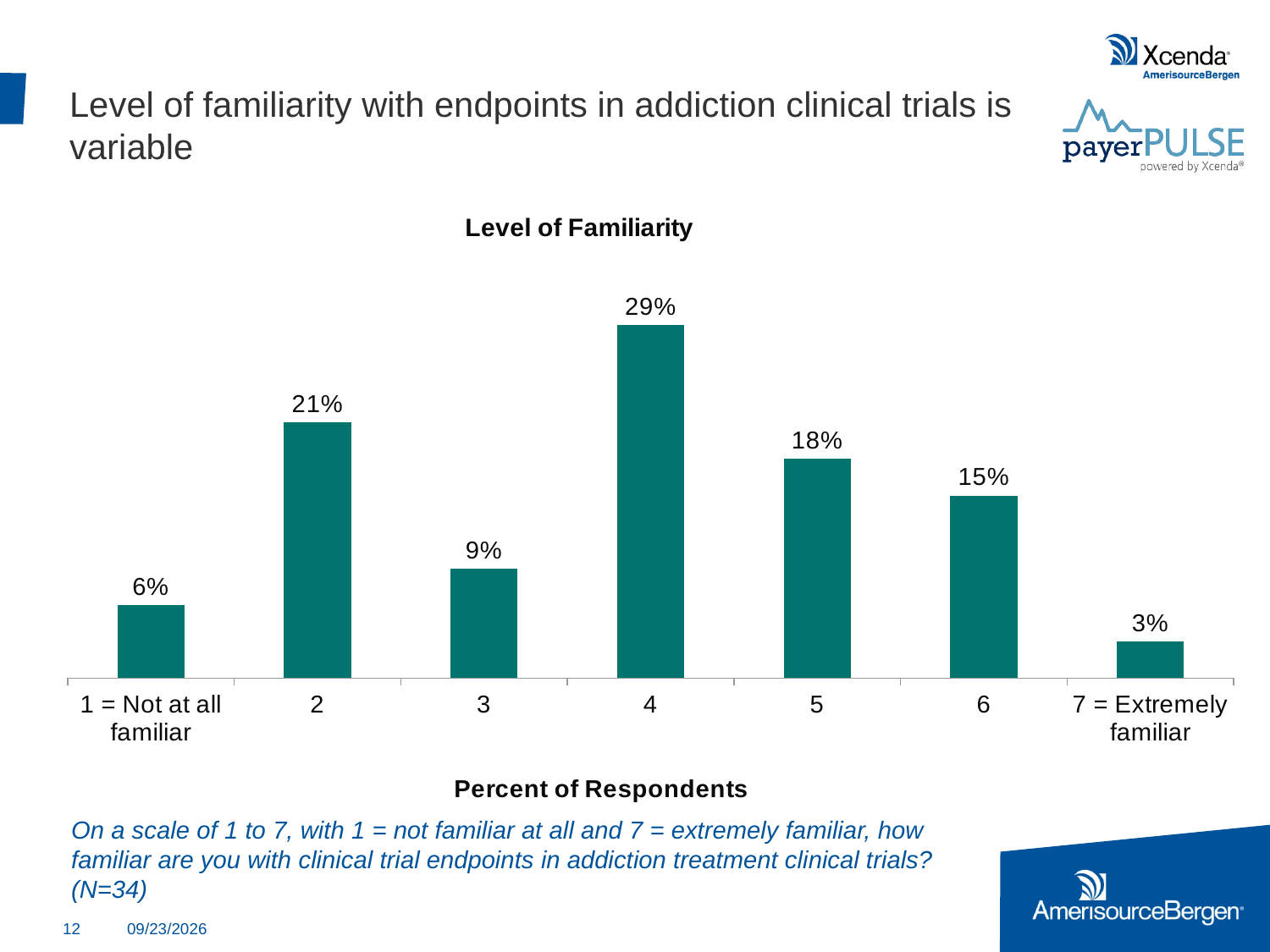
How many rating categories are shown on the x axis? 7 What is the title of the chart? Level of Familiarity What type of chart is shown on the slide? Bar chart Which has a higher percentage of respondents, rating 5 or rating 6? 5 What percentage of respondents chose 1 = Not at all familiar? 6% What percentage of respondents rated their familiarity as 4? 29% What is the label shown beneath the x axis of the chart? Percent of Respondents What is the difference in percentage points between rating 2 and rating 3? 12 What percentage of respondents chose 7 = Extremely familiar? 3% What is the value shown for rating 6? 15% Which rating level has the highest percentage of respondents? 4 Which rating level has the lowest percentage of respondents? 7 = Extremely familiar